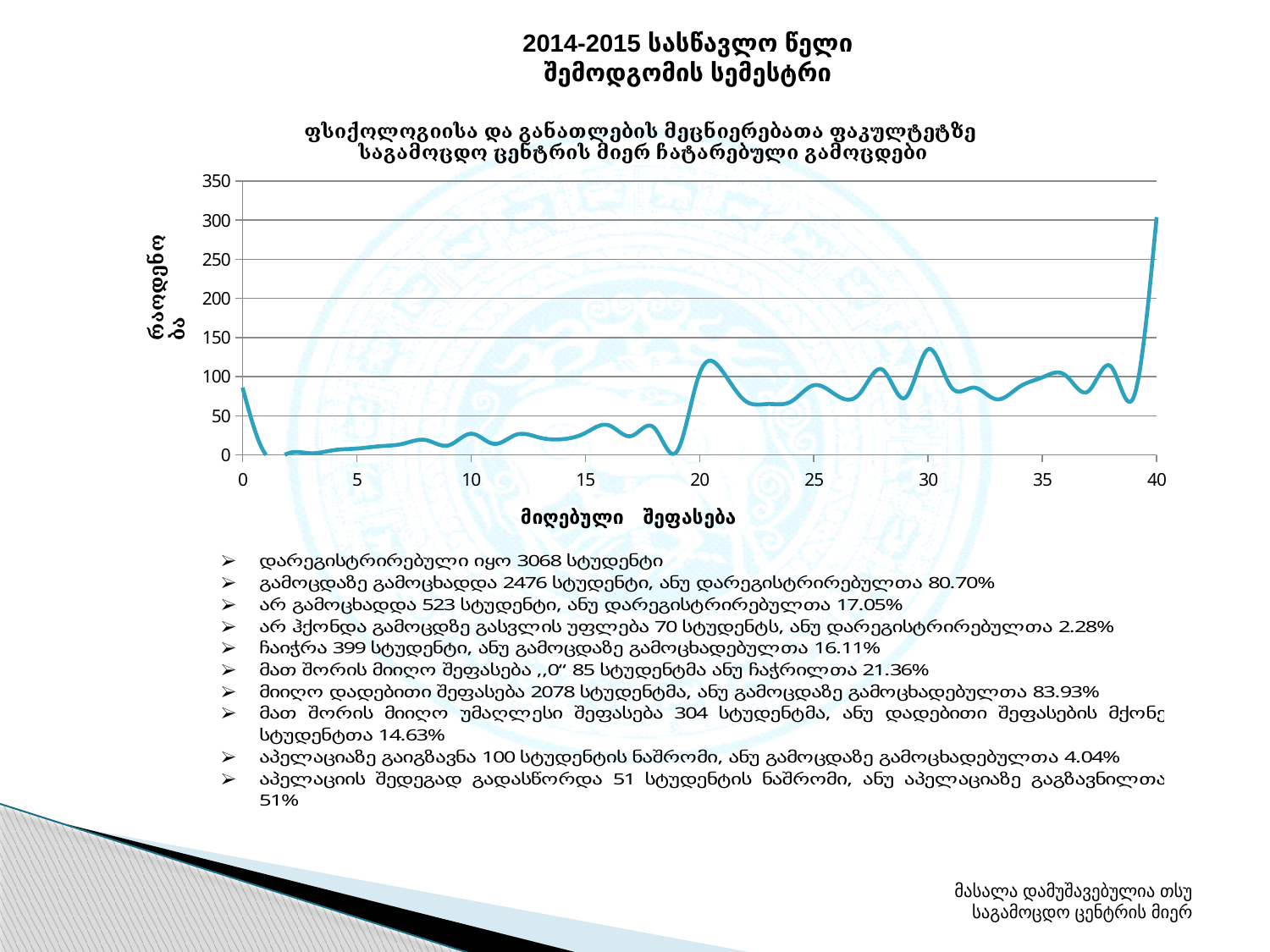
Is the value at x = 0 greater or less than 50? greater Is the value at x = 15 greater or less than 50? less What kind of chart is shown on the slide? line chart Between x = 0 and x = 1, does the line rise or fall? fall What is the title of the x axis? მიღებული შეფასება Which is larger: the value at x = 40 or the value at x = 30? x = 40 Is the value at x = 5 greater or less than 50? less Which is larger: the value at x = 10 or the value at x = 25? x = 25 At which x-axis value (მიღებული შეფასება) does the line reach its highest point? 40